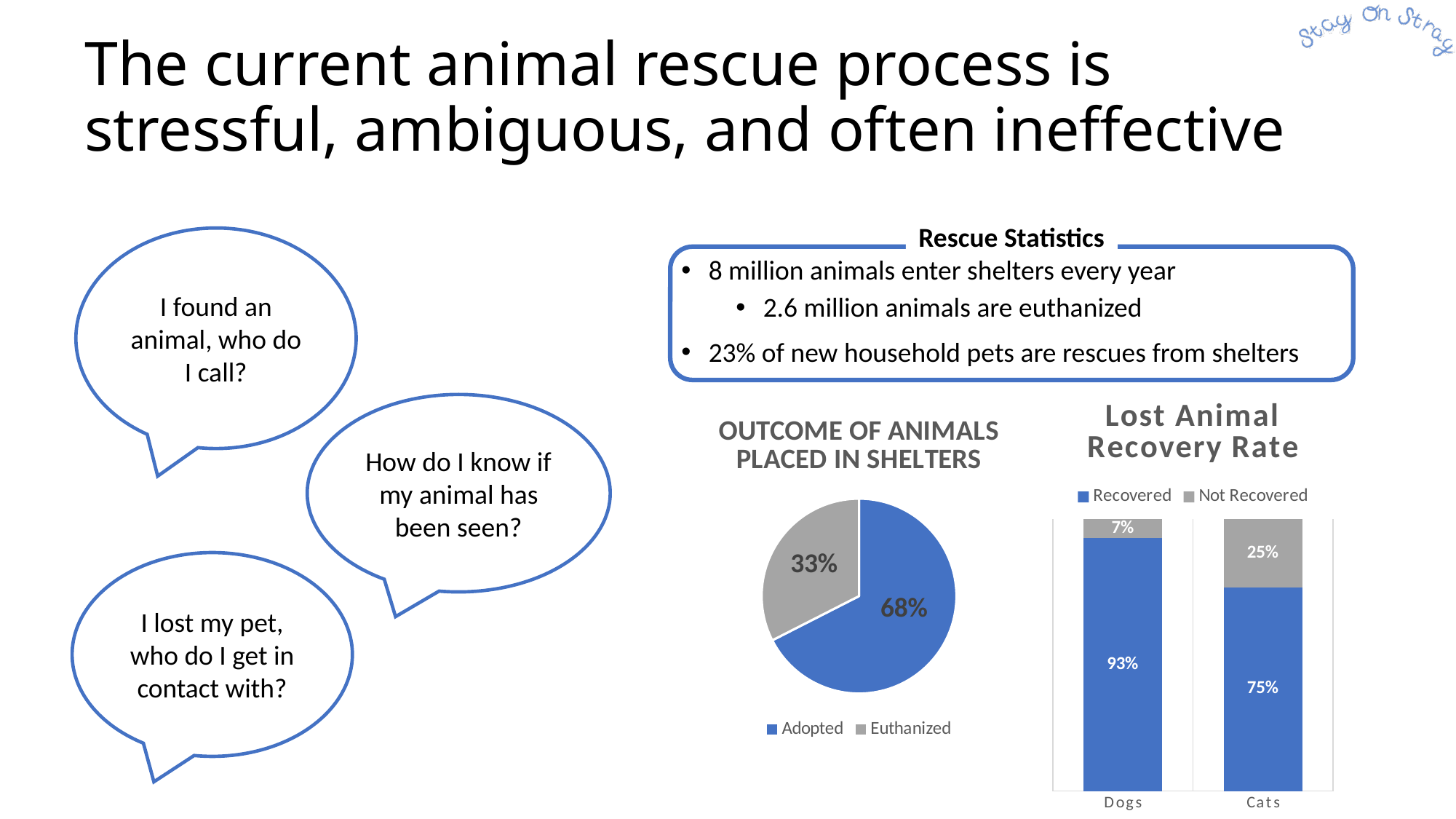
In the 'Lost Animal Recovery Rate' chart, what is the Not Recovered value for Dogs? 7% In the 'Outcome of Animals Placed in Shelters' chart, which slice is larger, Adopted or Euthanized? Adopted In the 'Lost Animal Recovery Rate' chart, what is the Not Recovered value for Cats? 25% In the 'Lost Animal Recovery Rate' chart, what is the Recovered value for Dogs? 93% How many categories are shown on the x axis of the 'Lost Animal Recovery Rate' chart? 2 In the 'Outcome of Animals Placed in Shelters' chart, what percentage of animals are adopted? 68% In the 'Lost Animal Recovery Rate' chart, what is the difference between the Recovered values for Dogs and Cats? 18% How many series does the legend of the 'Outcome of Animals Placed in Shelters' chart list? 2 In the 'Outcome of Animals Placed in Shelters' chart, what percentage of animals are euthanized? 33% In the 'Lost Animal Recovery Rate' chart, which category has the higher Recovered value? Dogs What kind of chart is 'Outcome of Animals Placed in Shelters'? Pie chart What kind of chart is 'Lost Animal Recovery Rate'? Stacked bar chart